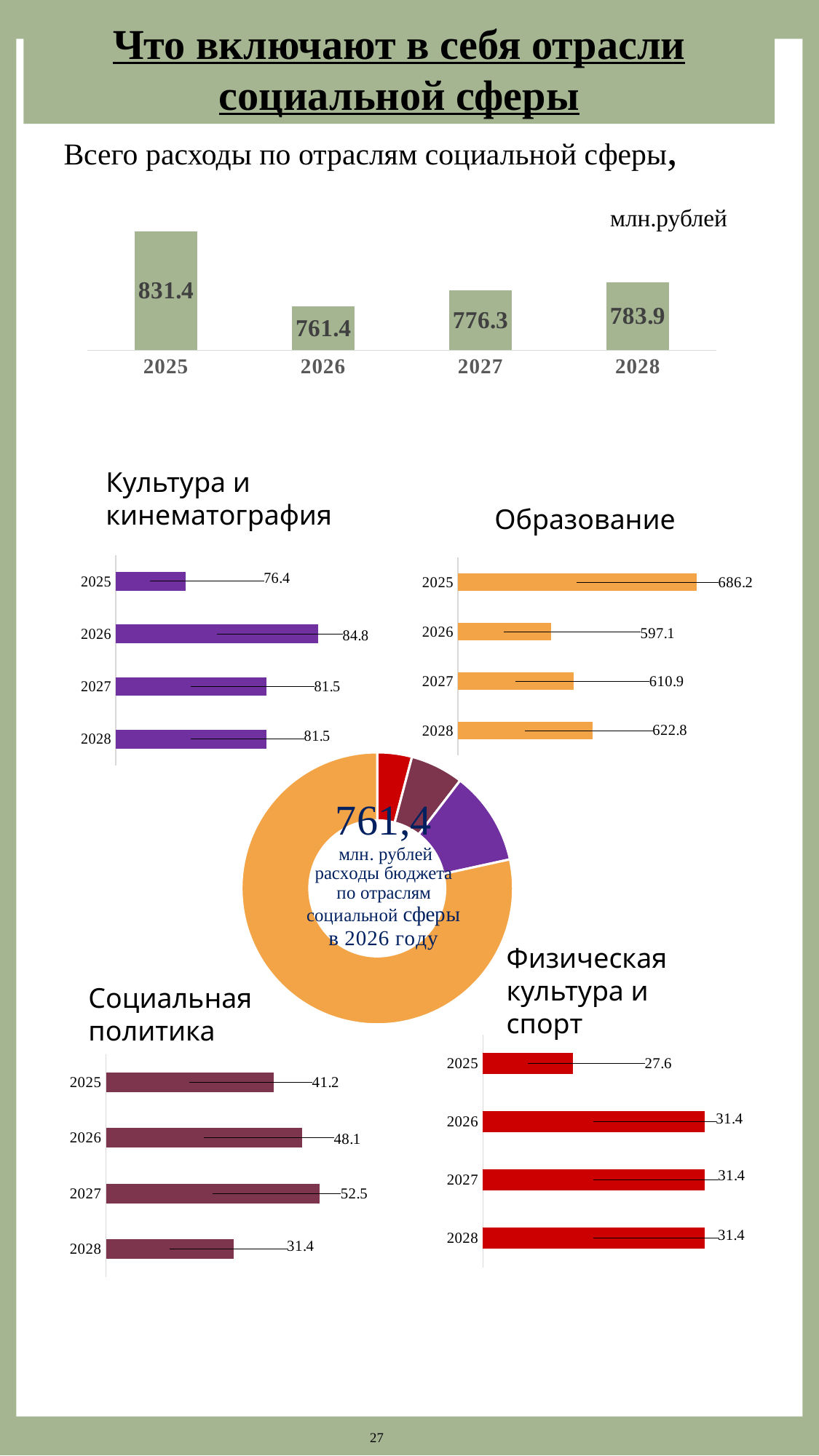
In the chart 'Всего расходы по отраслям социальной сферы', what is the value for 2025? 831.4 In the chart 'Физическая культура и спорт', what is the value for 2025? 27.6 In the chart 'Образование', which year has the highest value? 2025 In the chart 'Всего расходы по отраслям социальной сферы', what is the difference between the 2025 and 2026 values? 70.0 In the chart 'Социальная политика', which year has the highest value? 2027 In the chart 'Образование', what is the value for 2027? 610.9 In the chart 'Культура и кинематография', what is the value for 2026? 84.8 In the chart 'Культура и кинематография', which is larger, the value for 2025 or the value for 2027? 2027 In the chart 'Всего расходы по отраслям социальной сферы', which year has the lowest value? 2026 In the chart 'Социальная политика', what is the value for 2028? 31.4 What kind of chart is the chart 'Всего расходы по отраслям социальной сферы'? bar chart How many bars are in the chart 'Физическая культура и спорт'? 4